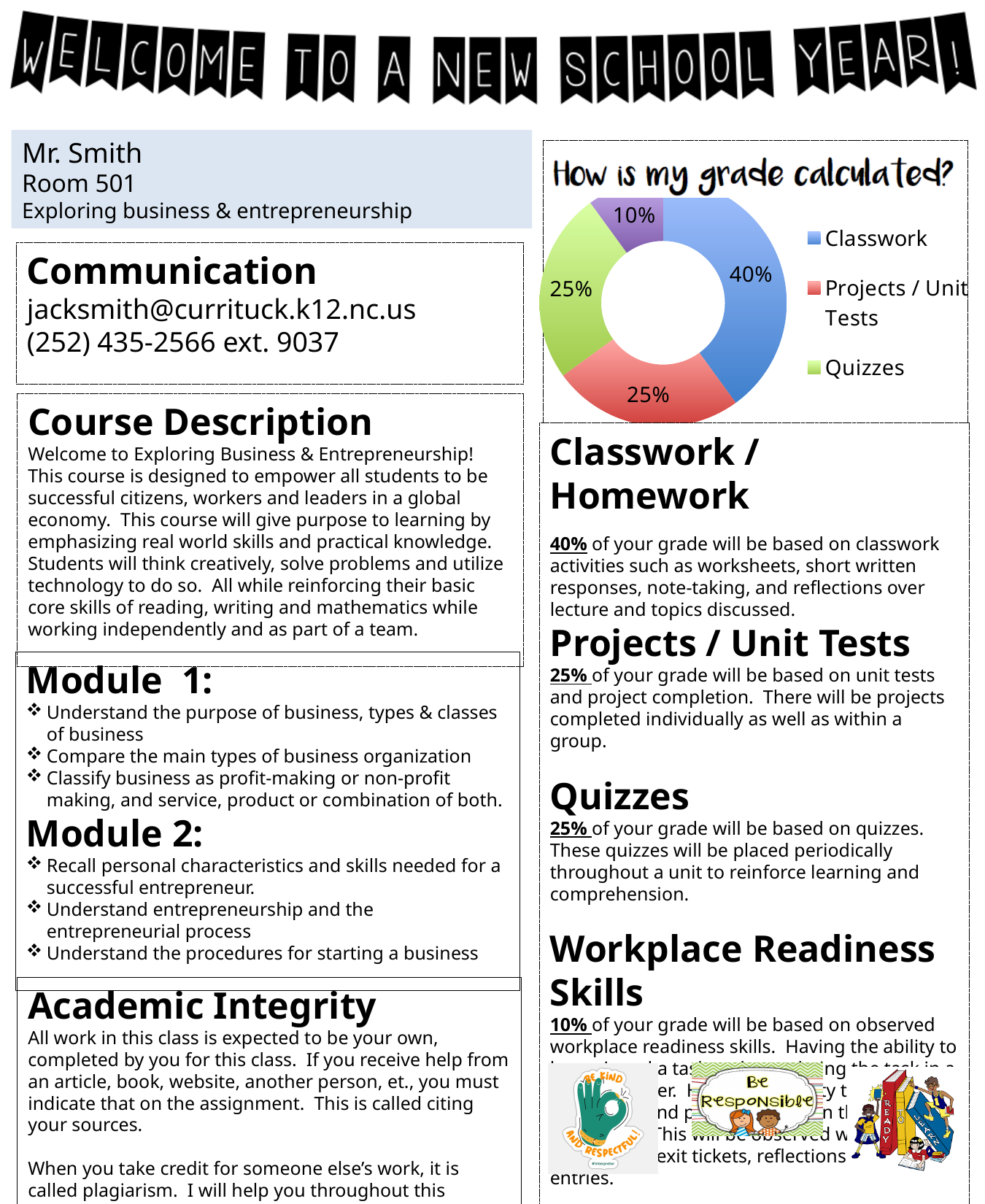
What kind of chart is shown under "How is my grade calculated?"? doughnut chart What is the percentage of the smallest slice in the doughnut chart? 10% What is the title of the chart? How is my grade calculated? What percentage is shown for the Quizzes slice? 25% How many percentage points larger is the Classwork slice than the Quizzes slice? 15% Which is larger, the Classwork slice or the Projects / Unit Tests slice? Classwork What do the Classwork and Quizzes slices add up to? 65% What colour is the Classwork slice in the doughnut chart? blue Which legend category has the largest slice of the doughnut chart? Classwork What percentage of the grade does the Classwork slice represent? 40% How many slices does the doughnut chart have? 4 What percentage is shown for the Projects / Unit Tests slice? 25%